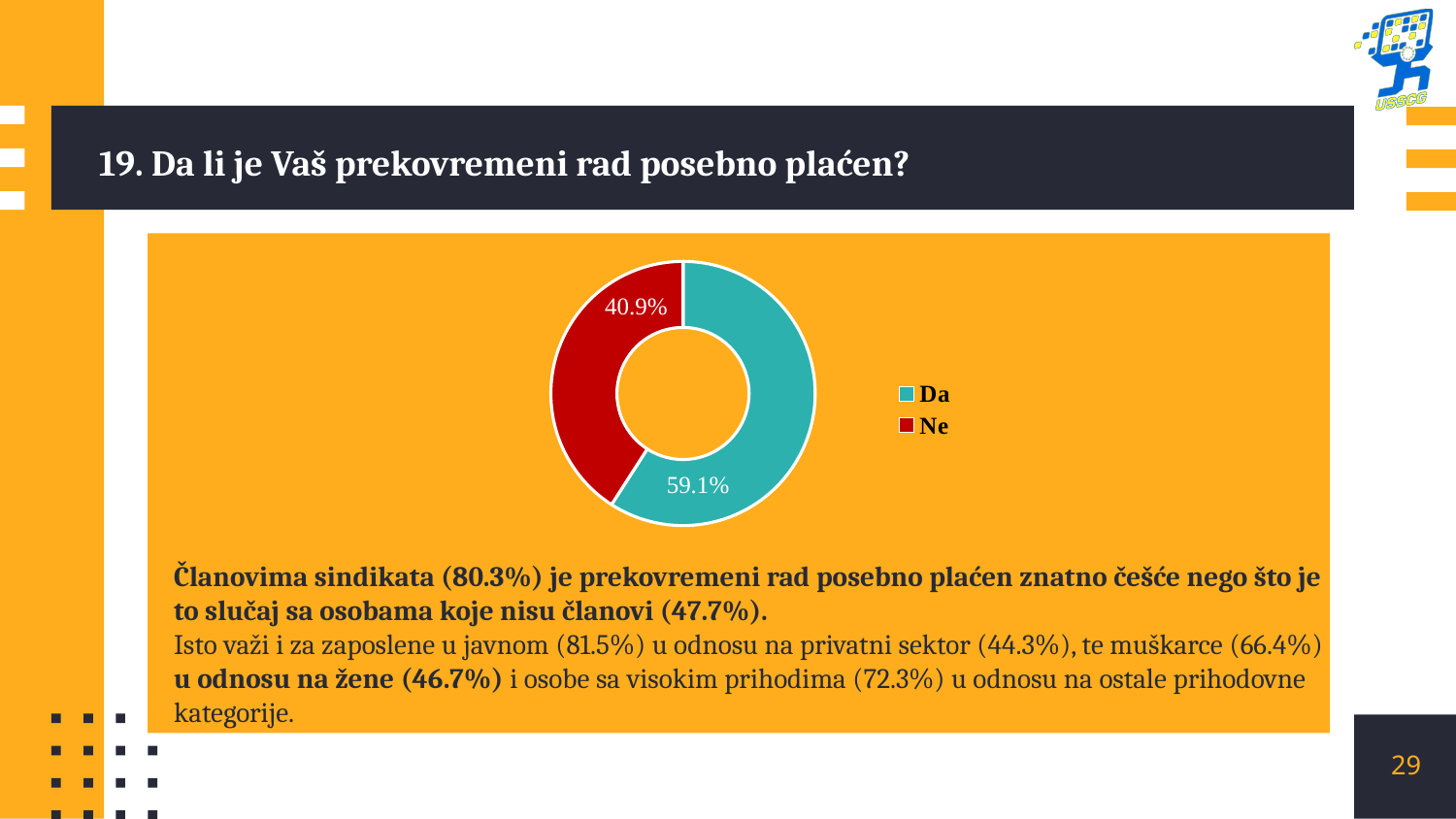
Which answer has the larger share, "Da" or "Ne"? Da Which category has the smallest share of the chart? Ne How many categories are shown in the chart? 2 How many entries does the legend list? 2 Is the share for "Da" greater or less than 50%? greater Which category has the largest share of the chart? Da What colour represents "Da" in the chart? Teal What kind of chart is shown on the slide? Doughnut (pie) chart What is the difference in percentage points between the "Da" and "Ne" shares? 18.2 What percentage of respondents answered "Da"? 59.1% What percentage of respondents answered "Ne"? 40.9% What colour represents "Ne" in the chart? Red